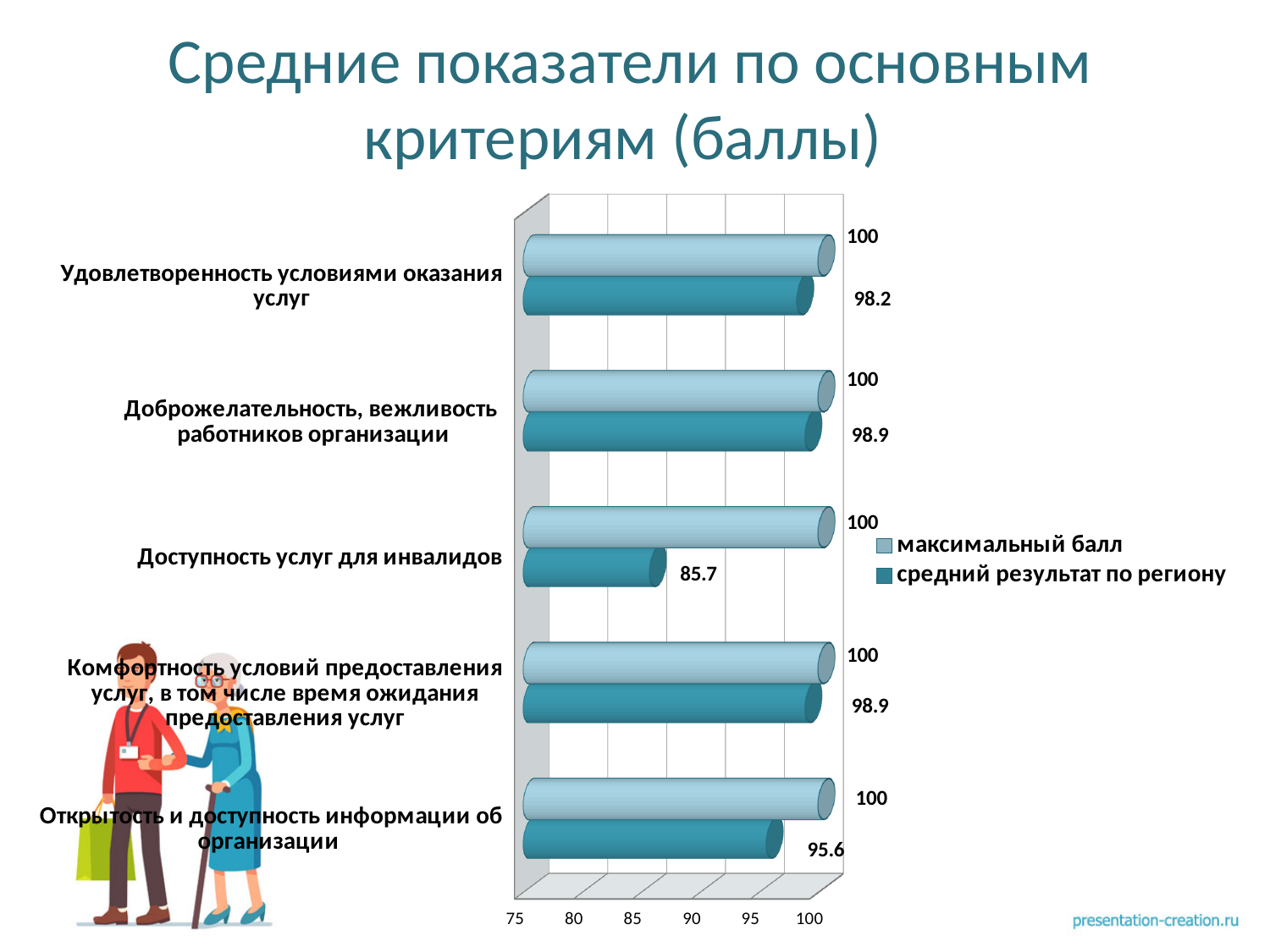
Which is larger: "средний результат по региону" for "Открытость и доступность информации об организации" or for "Доступность услуг для инвалидов"? Открытость и доступность информации об организации How many categories are shown on the chart? 5 What kind of chart is shown on the slide? bar chart Which category has the lowest value for "средний результат по региону"? Доступность услуг для инвалидов What is the difference between "средний результат по региону" for "Доброжелательность, вежливость работников организации" and for "Открытость и доступность информации об организации"? 3.3 What is the difference between "максимальный балл" and "средний результат по региону" for "Доступность услуг для инвалидов"? 14.3 What is the value of "средний результат по региону" for "Удовлетворенность условиями оказания услуг"? 98.2 How many series does the legend list? 2 What is the value of "средний результат по региону" for "Открытость и доступность информации об организации"? 95.6 Is the value of "средний результат по региону" for "Доступность услуг для инвалидов" greater or less than 90? less What is the value of "максимальный балл" for "Доброжелательность, вежливость работников организации"? 100 What is the value of "средний результат по региону" for "Доступность услуг для инвалидов"? 85.7